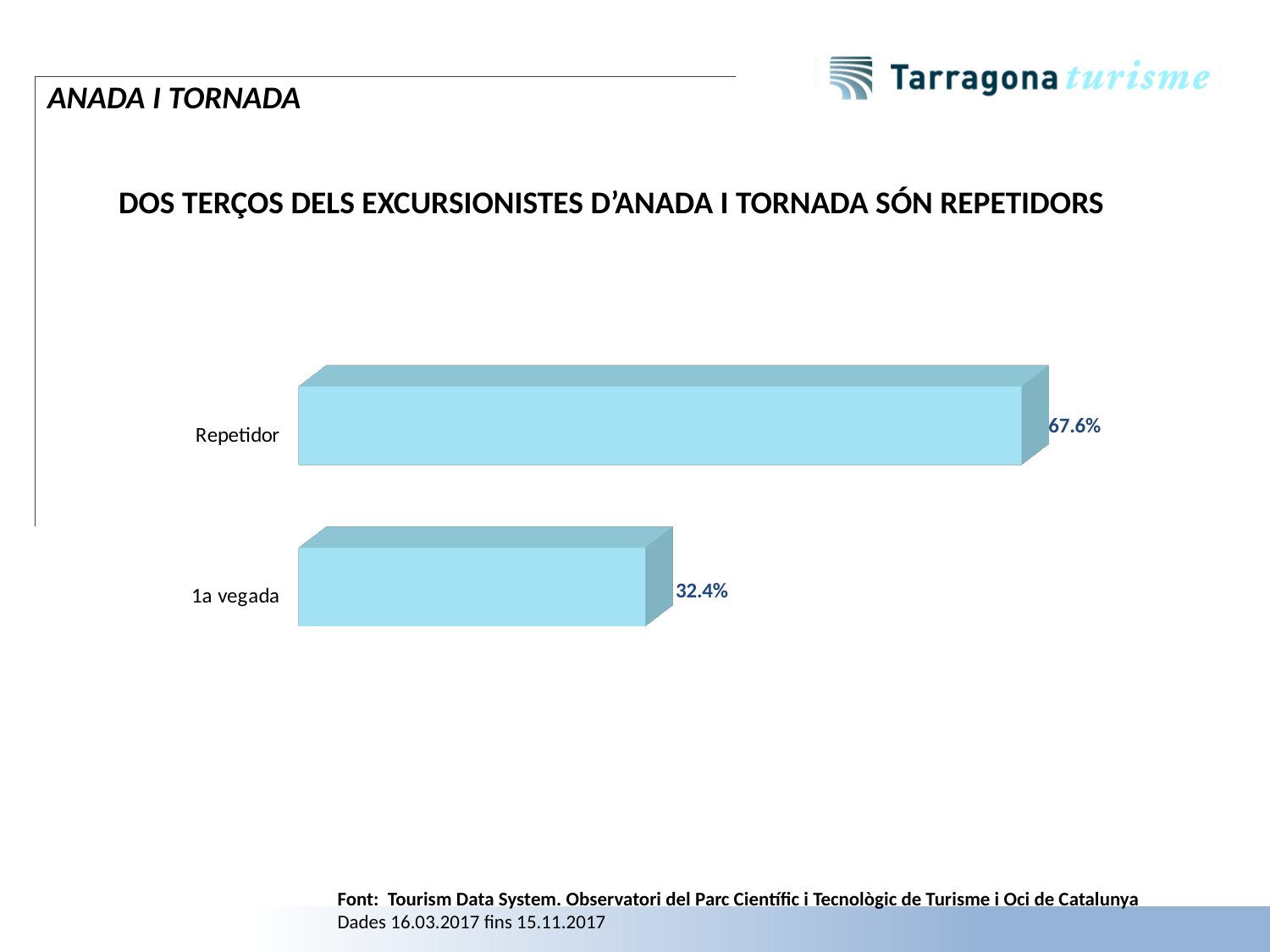
What colour are the bars in the chart? Light blue What is the value for Repetidor? 67.6% What is the difference between the values for Repetidor and 1a vegada? 35.2% What is the total of the two values shown in the chart? 100% Which category has the lowest value? 1a vegada What is the value for 1a vegada? 32.4% What kind of chart is shown on the slide? Bar chart Which is larger, the value for Repetidor or the value for 1a vegada? Repetidor How many categories are shown in the chart? 2 What is the heading text above the chart? DOS TERÇOS DELS EXCURSIONISTES D'ANADA I TORNADA SÓN REPETIDORS Which category has the highest value? Repetidor